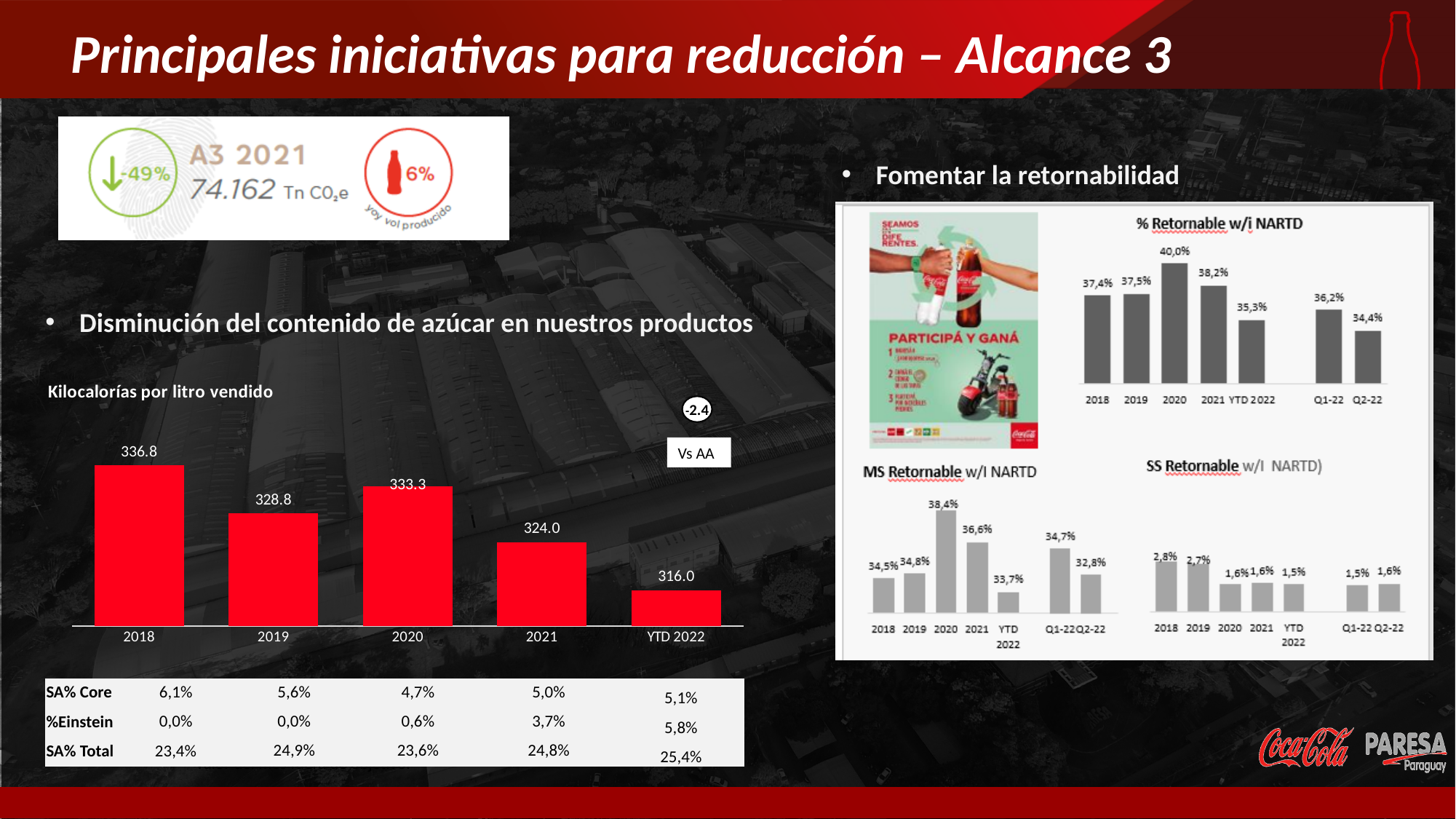
In the 'SS Retornable w/I NARTD' chart, what is the value for 2018? 2,8% In the '% Retornable w/i NARTD' chart, which category has the highest value? 2020 In the 'SS Retornable w/I NARTD' chart, how many bars are plotted? 7 In the '% Retornable w/i NARTD' chart, what is the value for 2020? 40,0% In the 'MS Retornable w/I NARTD' chart, what is the difference between the 2020 and 2021 values? 1,8% In the 'Kilocalorías por litro vendido' chart, which category has the lowest value? YTD 2022 In the '% Retornable w/i NARTD' chart, which is larger, Q1-22 or Q2-22? Q1-22 In the 'Kilocalorías por litro vendido' chart, how many bars are plotted? 5 In the 'Kilocalorías por litro vendido' chart, what is the difference between the 2018 and 2021 values? 12.8 What type of chart is the 'Kilocalorías por litro vendido' chart? bar chart In the 'Kilocalorías por litro vendido' chart, what is the value for 2018? 336.8 In the 'MS Retornable w/I NARTD' chart, what is the value for YTD 2022? 33,7%